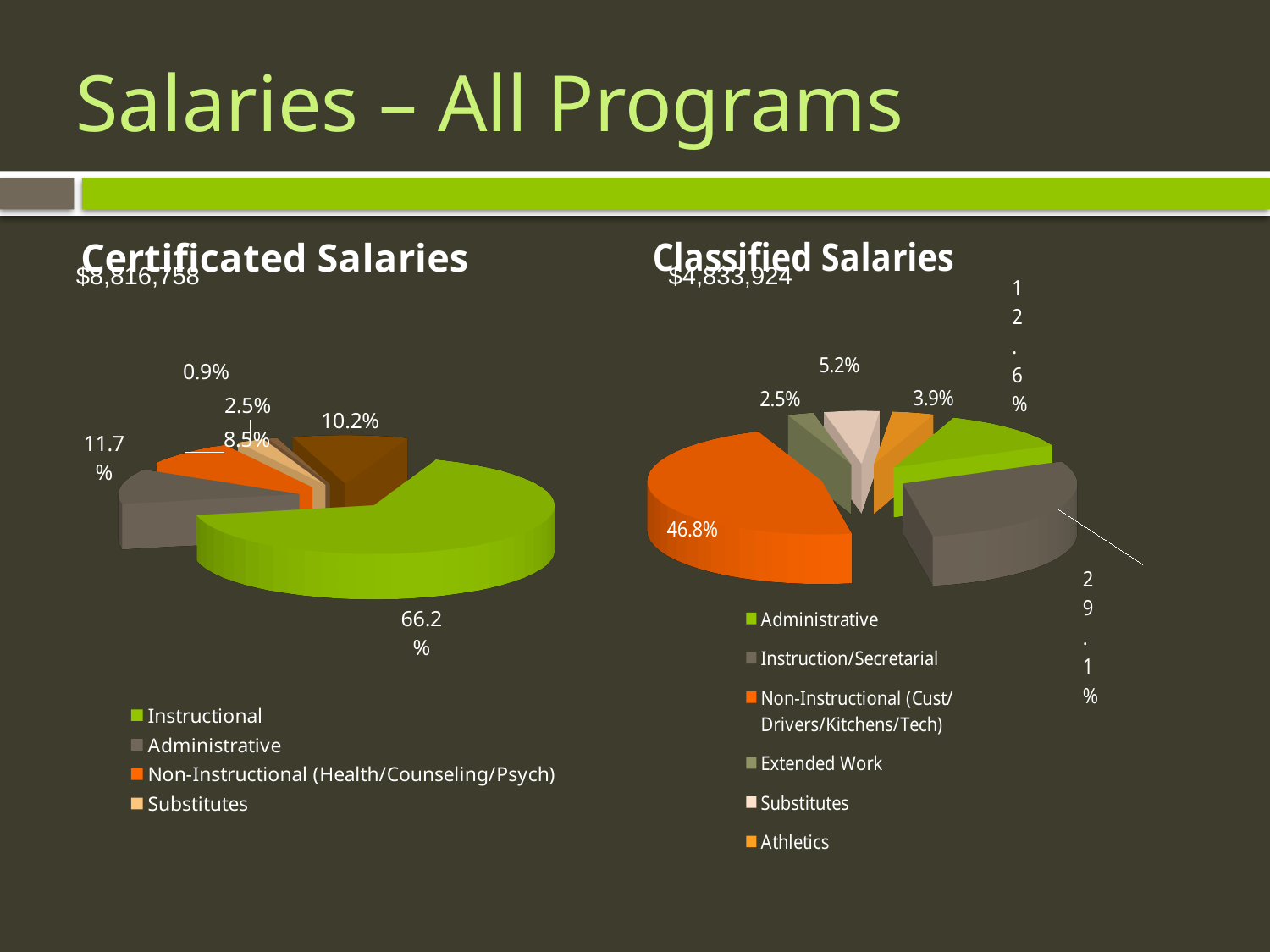
In the Certificated Salaries chart, which is larger, Administrative or Non-Instructional (Health/Counseling/Psych)? Administrative What total dollar amount is shown for the Classified Salaries chart? $4,833,924 In the Certificated Salaries chart, what share of the pie is Administrative? 11.7% In the Certificated Salaries chart, which legend category has the largest slice? Instructional In the Certificated Salaries chart, what share of the pie is Instructional? 66.2% In the Classified Salaries chart, what share of the pie is Non-Instructional (Cust/Drivers/Kitchens/Tech)? 46.8% How many categories does the legend of the Certificated Salaries chart list? 4 What kind of chart is used for the Certificated Salaries chart? Pie chart In the Classified Salaries chart, what is the difference in percentage points between Non-Instructional (Cust/Drivers/Kitchens/Tech) and Instruction/Secretarial? 17.7 percentage points In the Classified Salaries chart, which category has the smallest slice? Extended Work